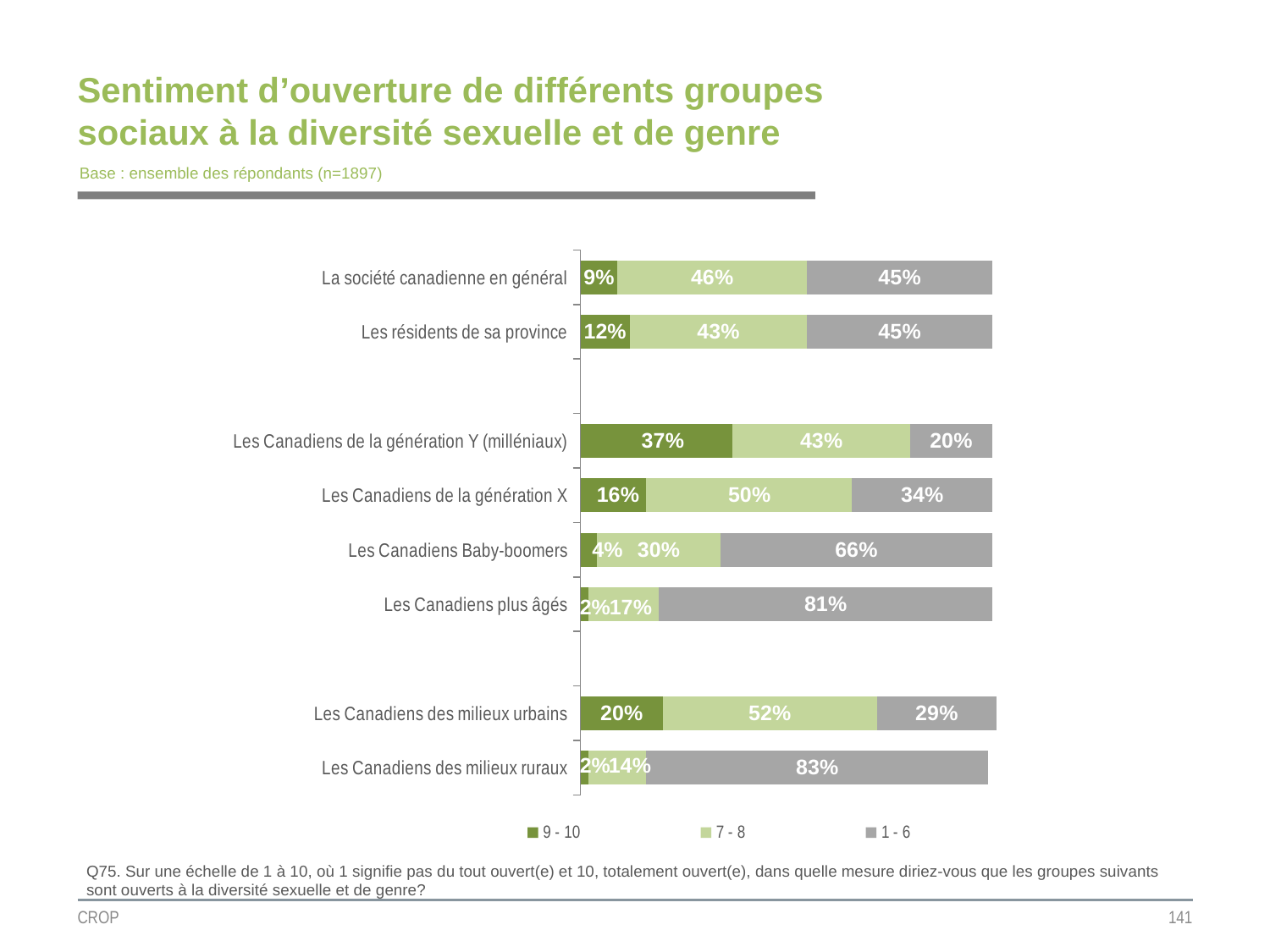
How many series does the legend list? 3 Which has a larger 7 - 8 value, Les Canadiens des milieux urbains or La société canadienne en général? Les Canadiens des milieux urbains What is the 1 - 6 value for Les Canadiens des milieux ruraux? 83% Which group has the lowest 1 - 6 value? Les Canadiens de la génération Y (milléniaux) What is the difference between the 1 - 6 values for Les Canadiens Baby-boomers and Les Canadiens de la génération X? 32% What kind of chart is shown on the slide? Stacked bar chart How many social groups (categories) are plotted in the chart? 8 What is the 7 - 8 value for Les Canadiens de la génération X? 50% What are the three legend entries of the chart? 9 - 10, 7 - 8, 1 - 6 What is the 9 - 10 value for Les Canadiens de la génération Y (milléniaux)? 37% What is the total of the three segments for Les Canadiens plus âgés? 100% Which group has the highest 9 - 10 value? Les Canadiens de la génération Y (milléniaux)